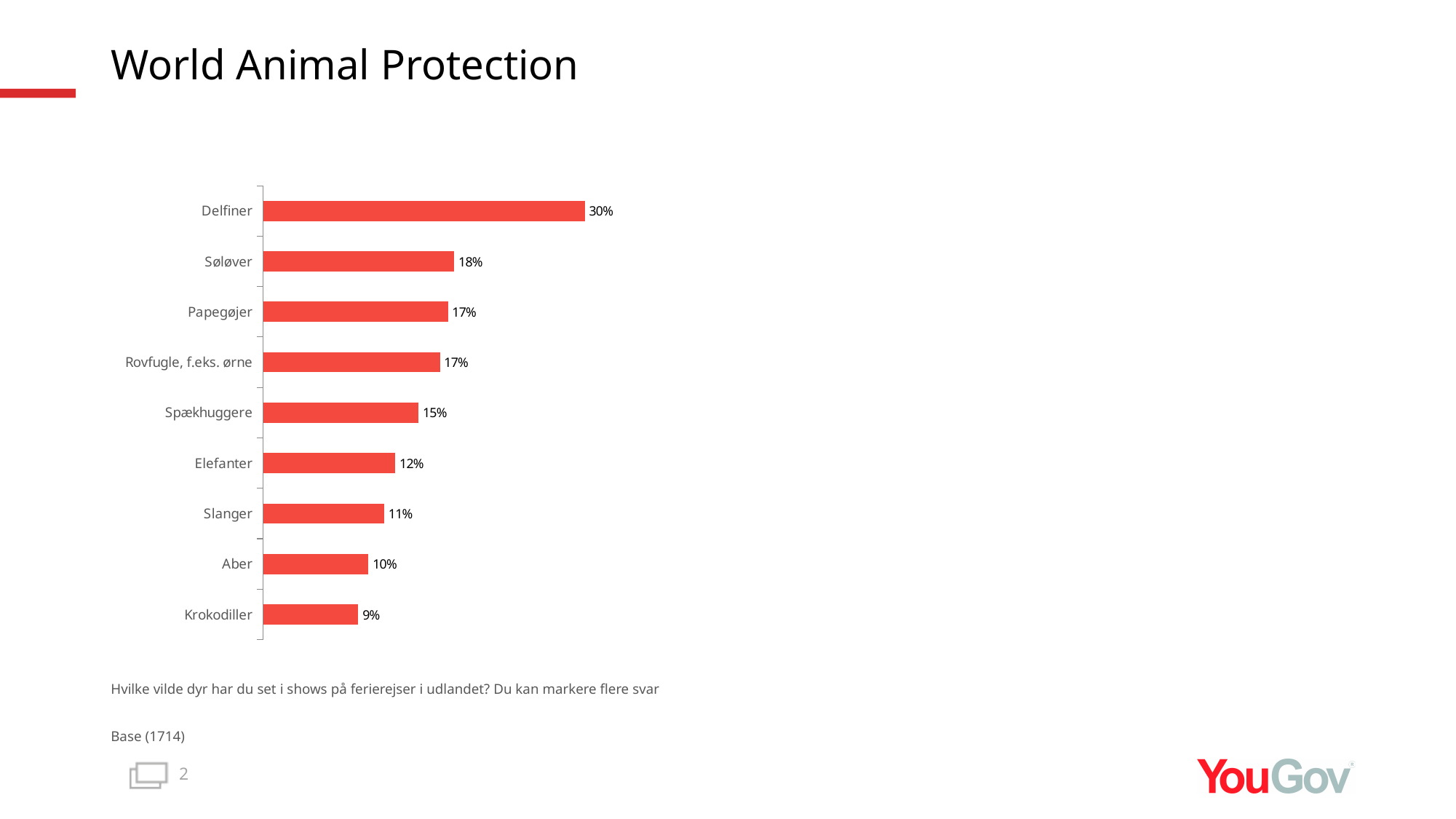
What type of chart is shown on the slide? Bar chart What is the base (number of respondents) stated below the chart? 1714 Which animal category has the lowest value? Krokodiller What is the difference between the values for Delfiner and Søløver? 12 percentage points What is the difference between the values for Elefanter and Aber? 2 percentage points Which has a higher value, Aber or Krokodiller? Aber Which has a higher value, Søløver or Spækhuggere? Søløver How many animal categories are shown in the chart? 9 What percentage is shown for Delfiner? 30% Which animal category has the highest value? Delfiner What percentage is shown for Slanger? 11% What value is shown for Spækhuggere? 15%